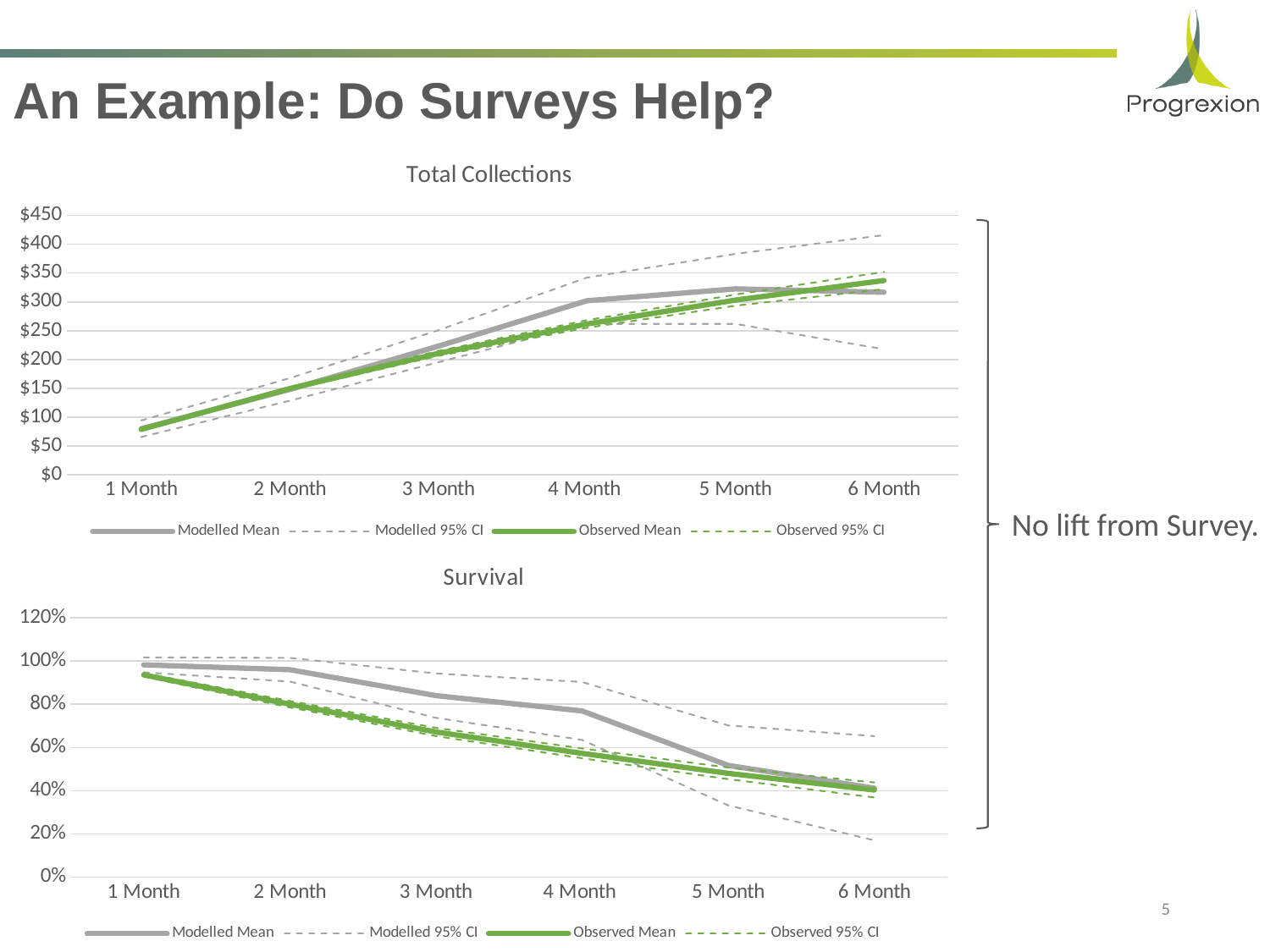
What is the title of the lower chart on the slide? Survival In the Survival chart, do the Modelled Mean values rise or fall from 1 Month to 6 Month? fall In the Total Collections chart, is the Observed Mean value at 1 Month greater or less than $100? less In the Survival chart, at 4 Month, which is larger: the Modelled Mean or the Observed Mean? Modelled Mean In the Total Collections chart, is the Modelled Mean value at 4 Month greater or less than $250? greater How many categories are on the x axis of the Total Collections chart? 6 In the Total Collections chart, do the Observed Mean values rise or fall from 1 Month to 6 Month? rise What kind of chart is the Total Collections chart? line chart How many series does the legend of the Survival chart list? 4 In the Survival chart, is the Observed Mean value at 1 Month greater or less than 80%? greater In the Total Collections chart, at 4 Month, which is larger: the Modelled Mean or the Observed Mean? Modelled Mean